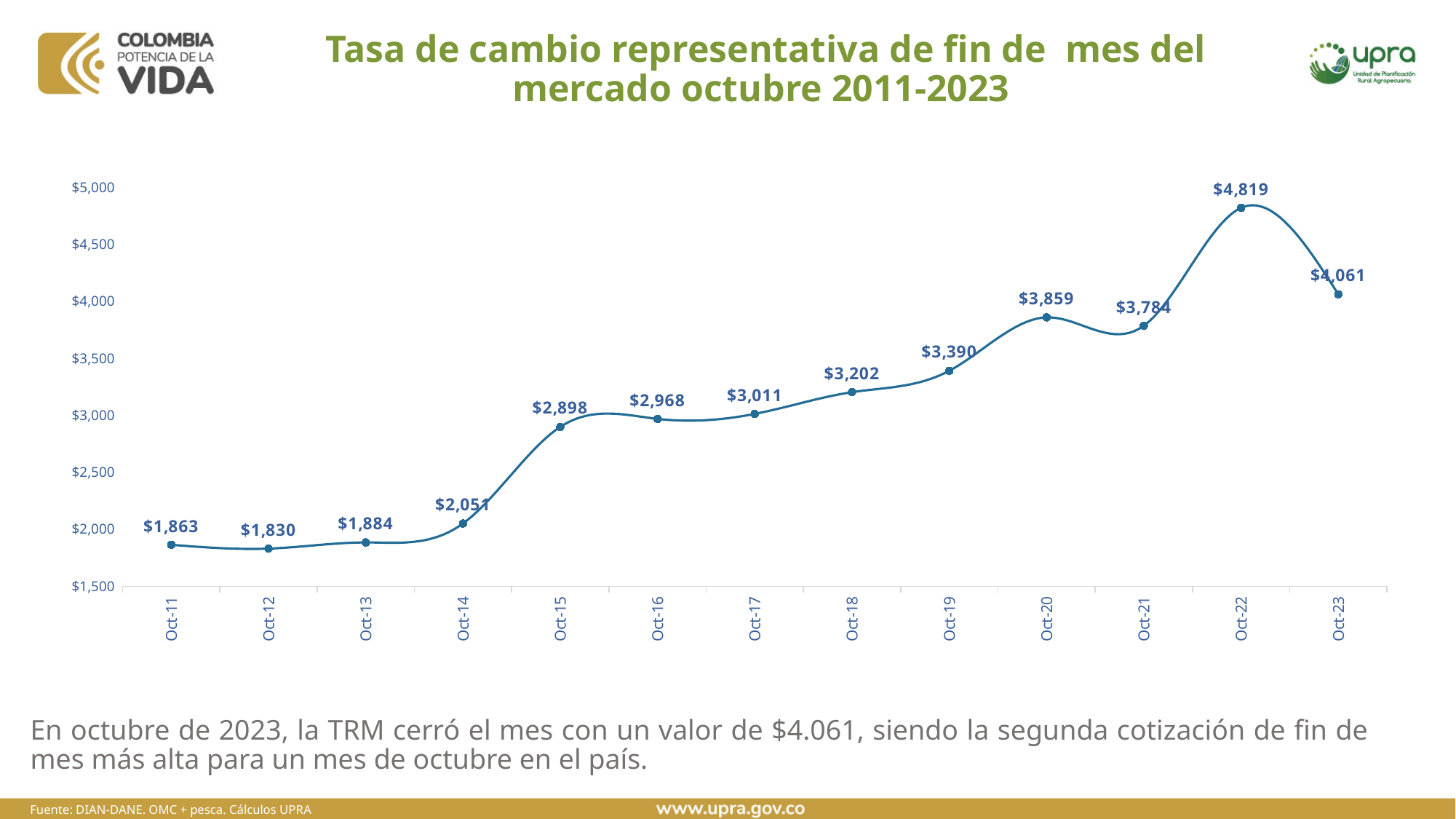
What is the title of the chart? Tasa de cambio representativa de fin de mes del mercado octubre 2011-2023 What is the value for Oct-11? $1,863 How many data points are plotted on the chart? 13 What is the value for Oct-20? $3,859 Which is larger, the value for Oct-20 or the value for Oct-21? Oct-20 What is the difference between the values for Oct-22 and Oct-23? $758 Do the values generally rise or fall from Oct-11 to Oct-22? rise Which month has the lowest value? Oct-12 What kind of chart is shown on the slide? line chart Is the value for Oct-19 greater or less than $3,500? less Which month has the highest value? Oct-22 What is the value for Oct-15? $2,898